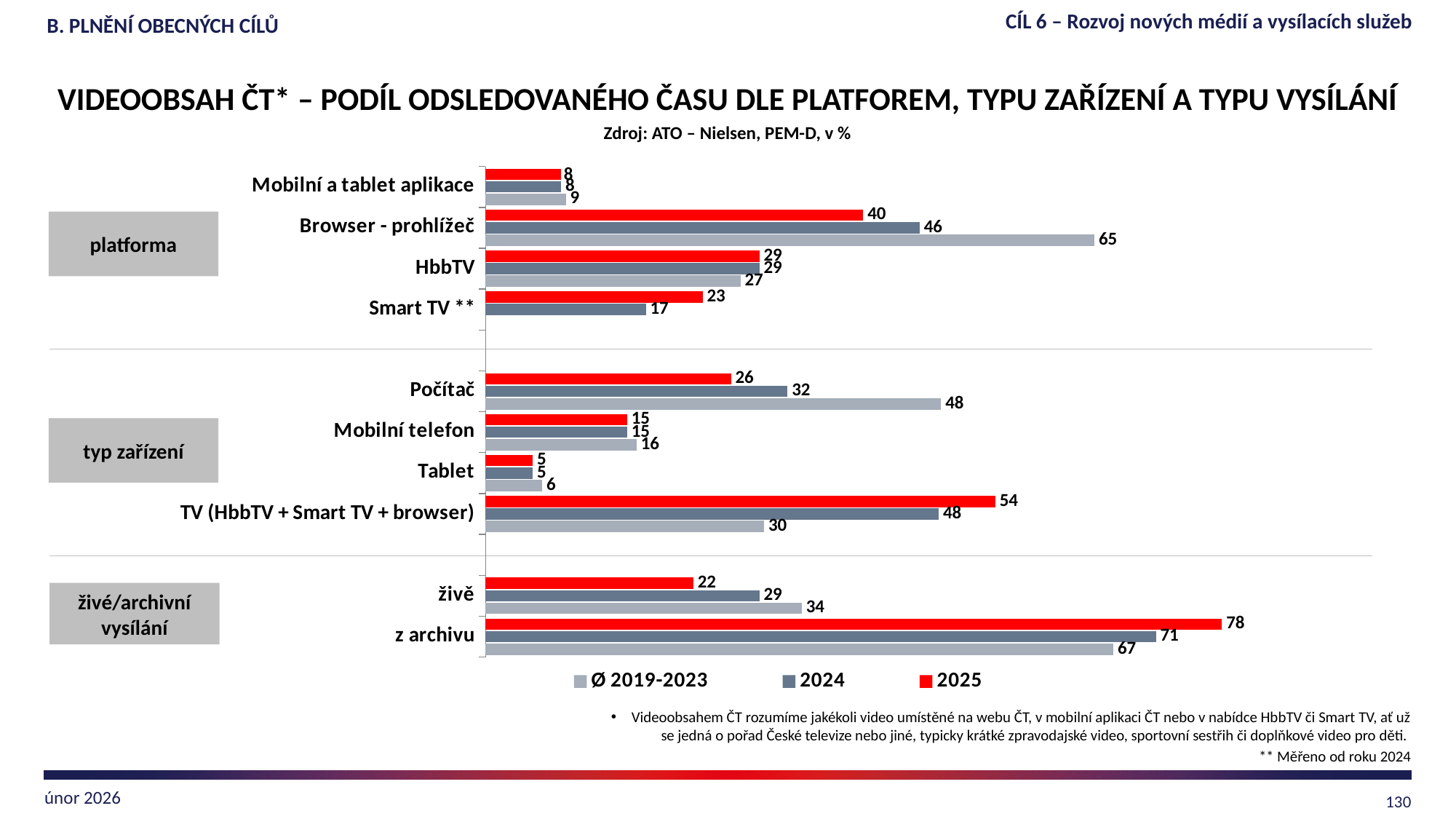
What is the 2025 value for Browser - prohlížeč? 40 Which category has the highest 2025 value? z archivu What is the 2024 value for z archivu? 71 Which colour represents the 2025 series in the legend? Red How many categories are shown on the chart? 10 Which category has the lowest Ø 2019-2023 value? Tablet What is the Ø 2019-2023 value for Počítač? 48 What is the 2025 value for Smart TV **? 23 How many series does the legend list? 3 Which is larger for TV (HbbTV + Smart TV + browser): the 2025 value or the Ø 2019-2023 value? 2025 What kind of chart is shown on the slide? Bar chart What is the difference between the Ø 2019-2023 and 2025 values for Browser - prohlížeč? 25